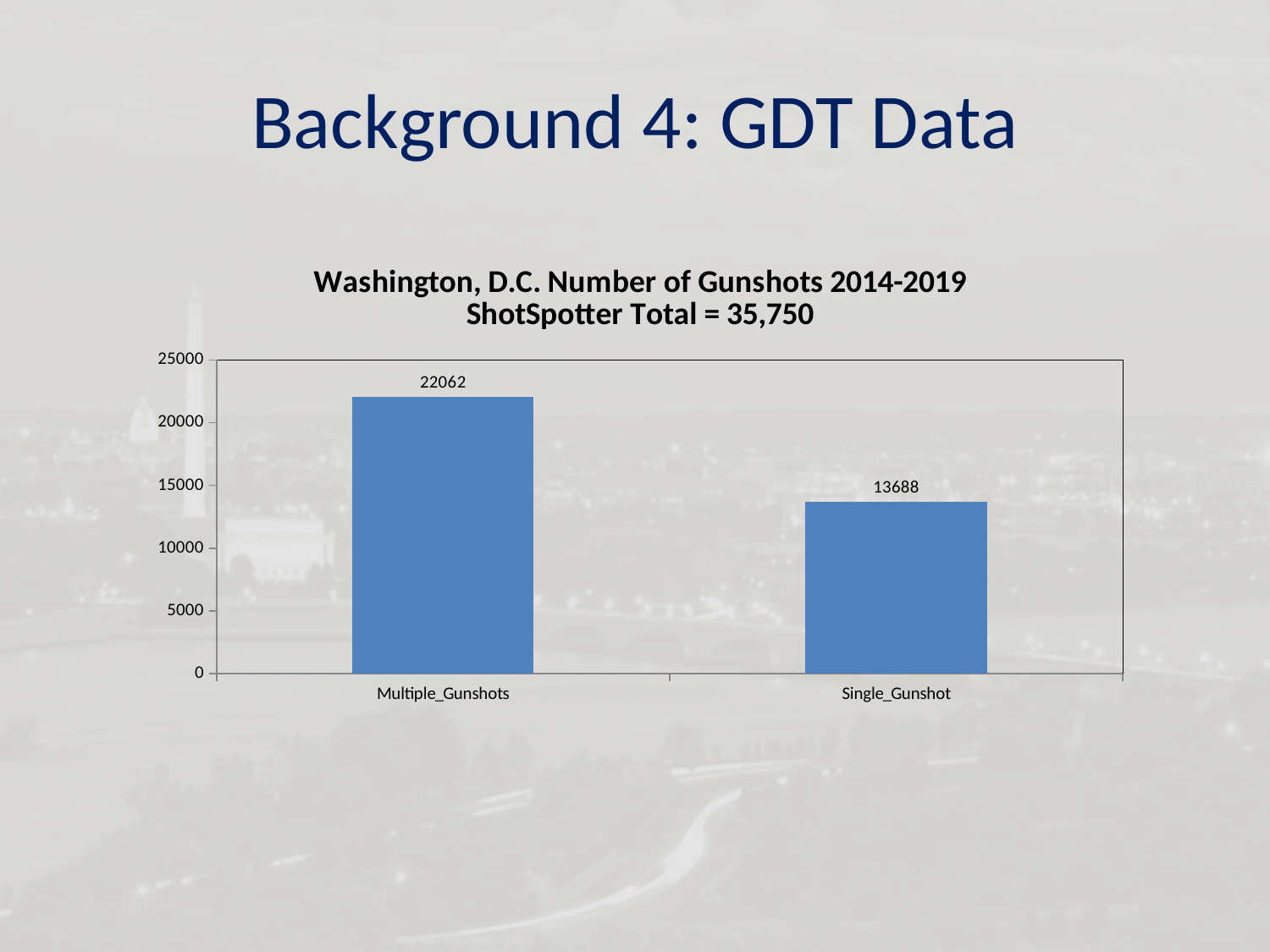
How many categories are shown on the x axis? 2 What is the value for Multiple_Gunshots? 22062 Which category has the lowest value? Single_Gunshot Which category has the highest value? Multiple_Gunshots What kind of chart is shown on the slide? bar chart What is the title of the chart? Washington, D.C. Number of Gunshots 2014-2019 ShotSpotter Total = 35,750 Is the value for Multiple_Gunshots greater or less than 20000? greater What is the highest value shown on the y axis? 25000 Is the value for Single_Gunshot greater or less than 15000? less What is the value for Single_Gunshot? 13688 What is the difference between the values for Multiple_Gunshots and Single_Gunshot? 8374 Which is larger, the value for Multiple_Gunshots or the value for Single_Gunshot? Multiple_Gunshots